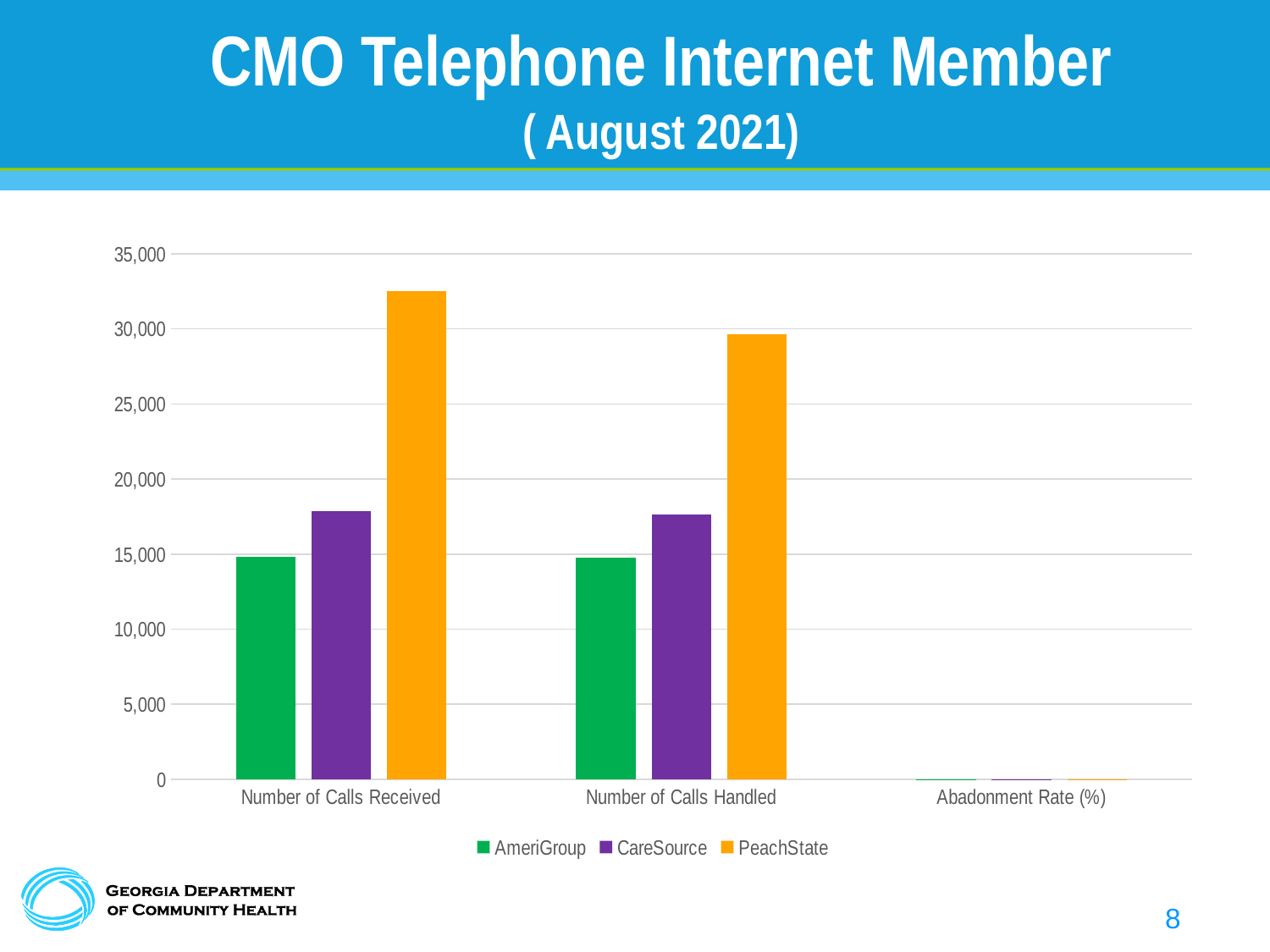
Is the value for AmeriGroup's Number of Calls Handled greater or less than 10,000? greater Is the value for PeachState's Number of Calls Received greater or less than 30,000? greater For PeachState, which is larger: Number of Calls Received or Number of Calls Handled? Number of Calls Received For Number of Calls Received, which is larger: CareSource or AmeriGroup? CareSource Is the value for CareSource's Number of Calls Received greater or less than 20,000? less Which CMO has the lowest Number of Calls Handled? AmeriGroup Which colour represents PeachState in the legend? orange What kind of chart is shown on the slide? bar chart Which CMO has the highest Number of Calls Received? PeachState How many categories are shown on the x axis? 3 How many series does the legend list? 3